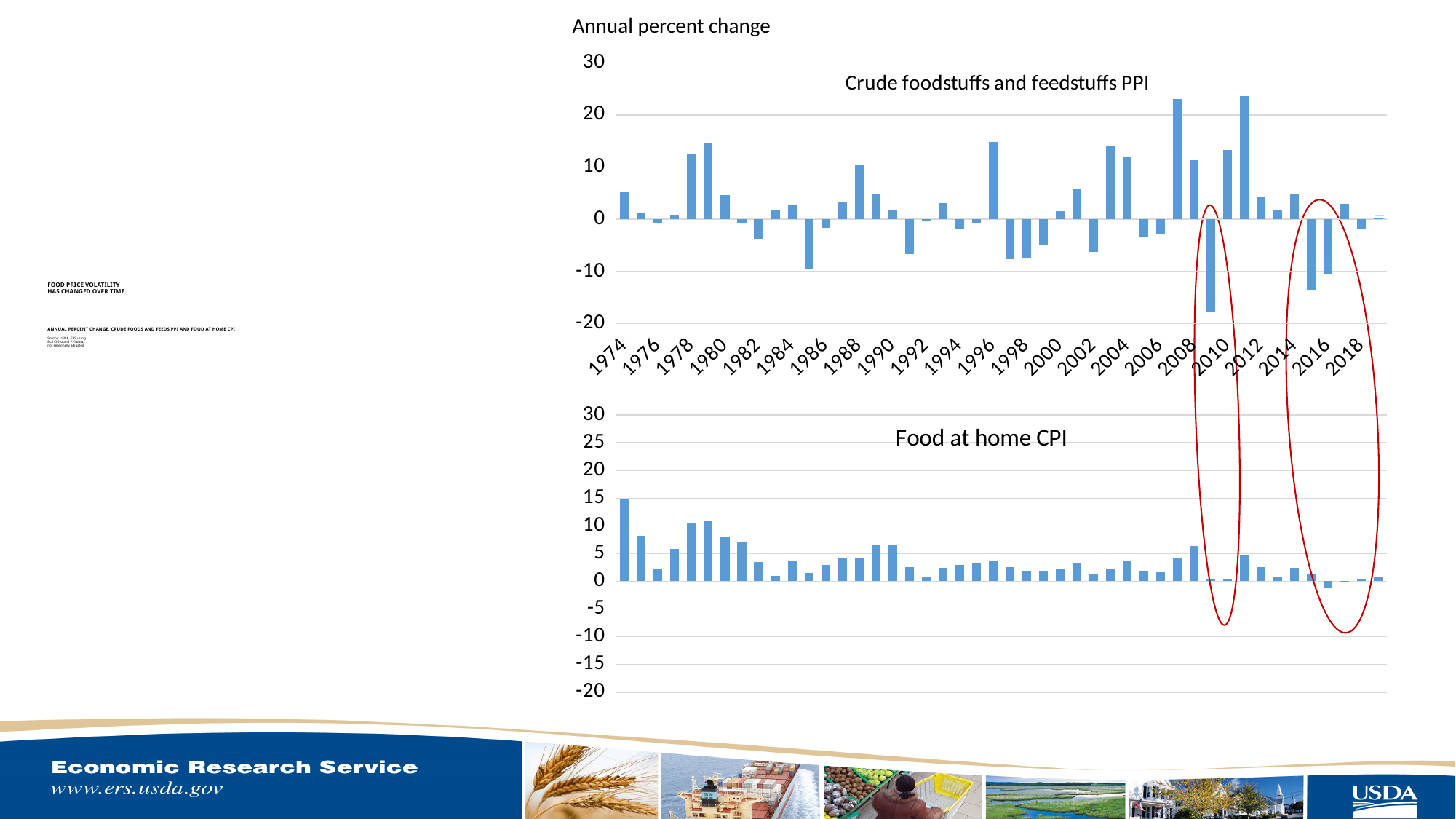
In the Food at home CPI chart, which year has the lowest value? 2016 What type of chart is the Crude foodstuffs and feedstuffs PPI chart? Bar chart In the Food at home CPI chart, do the values rise or fall from 1980 to 1982? Fall In the Food at home CPI chart, is the value for 2016 greater or less than 0? less In the Crude foodstuffs and feedstuffs PPI chart, is the lowest value greater or less than -15? less What is the axis title shown above the charts? Annual percent change In the Food at home CPI chart, is the value for 1974 greater or less than 10? greater In the Food at home CPI chart, which year has the highest value? 1974 In the Crude foodstuffs and feedstuffs PPI chart, which is larger, the value for 2010 or the value for 2012? 2010 In the Food at home CPI chart, which is larger, the value for 1974 or the value for 1976? 1974